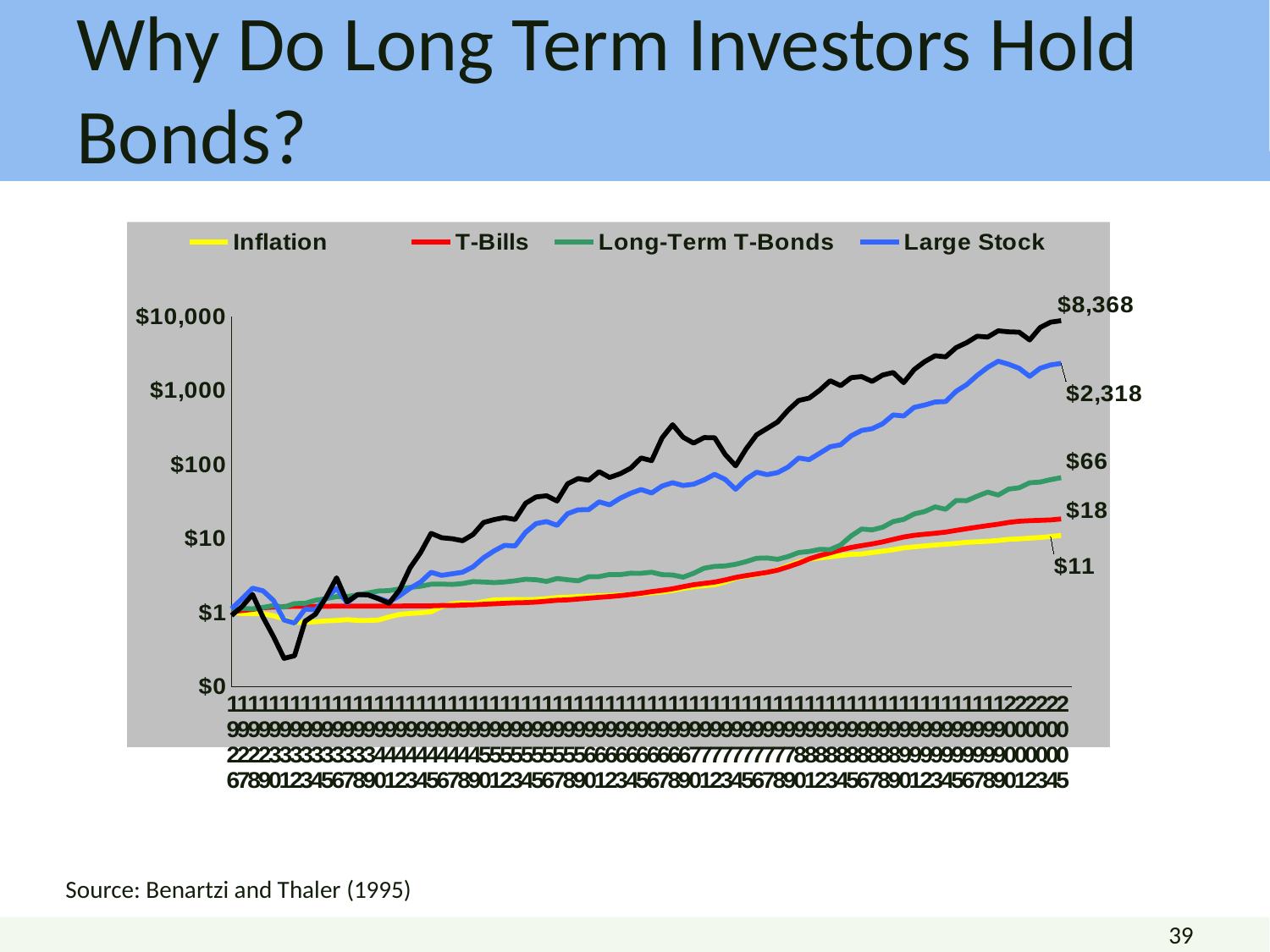
What is the final labelled value of the Large Stock line? $2,318 How many series does the chart's legend list? 4 Which ends higher, the Large Stock line or the Long-Term T-Bonds line? Large Stock What is the final labelled value of the Inflation line? $11 Does the Large Stock line generally rise or fall from left to right? rise What is the final labelled value of the T-Bills line? $18 What is the difference between the final labelled values of T-Bills and Inflation? $7 What is the difference between the final labelled values of Long-Term T-Bonds and T-Bills? $48 What is the final labelled value of the Long-Term T-Bonds line? $66 Is the final value of the Large Stock line greater or less than $1,000? greater What kind of chart is shown on the slide? line chart Of the series listed in the legend, which ends at the lowest value? Inflation